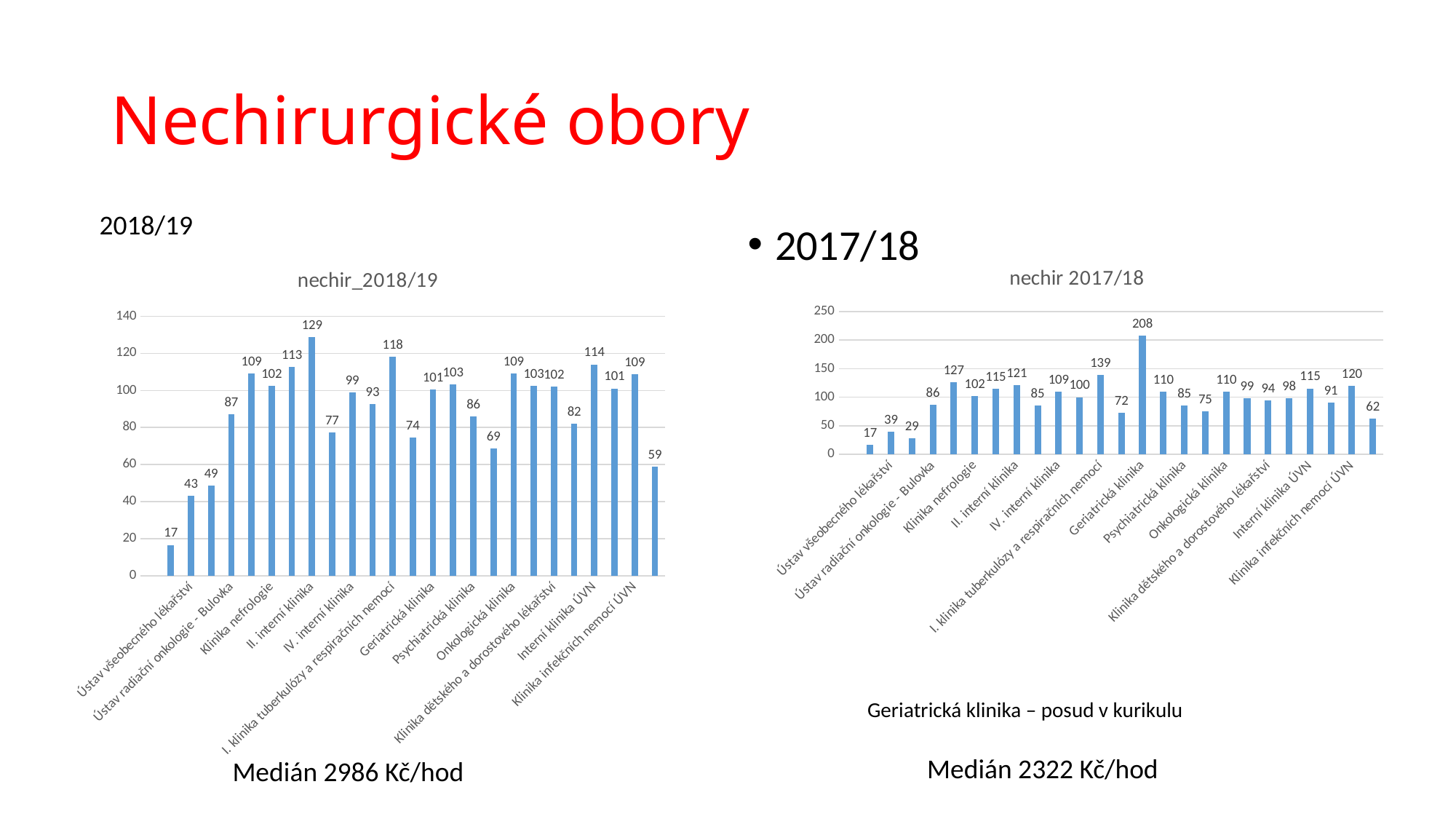
In the nechir_2018/19 chart, what is the value for Ústav všeobecného lékařství? 43 In the nechir 2017/18 chart, what is the value for Ústav všeobecného lékařství? 39 In the nechir_2018/19 chart, what is the lowest value shown? 17 In the nechir_2018/19 chart, what is the highest value shown? 129 What kind of chart is the nechir_2018/19 chart on the left? bar chart How many bars are plotted in the nechir_2018/19 chart? 25 What is the title of the chart on the left of the slide? nechir_2018/19 In the nechir 2017/18 chart, what is the highest value shown? 208 How many bars are plotted in the nechir 2017/18 chart? 25 In the nechir 2017/18 chart, what is the difference between the highest value (208) and the lowest value (17)? 191 Which chart has the larger maximum value, nechir_2018/19 or nechir 2017/18? nechir 2017/18 In the nechir 2017/18 chart, what is the lowest value shown? 17